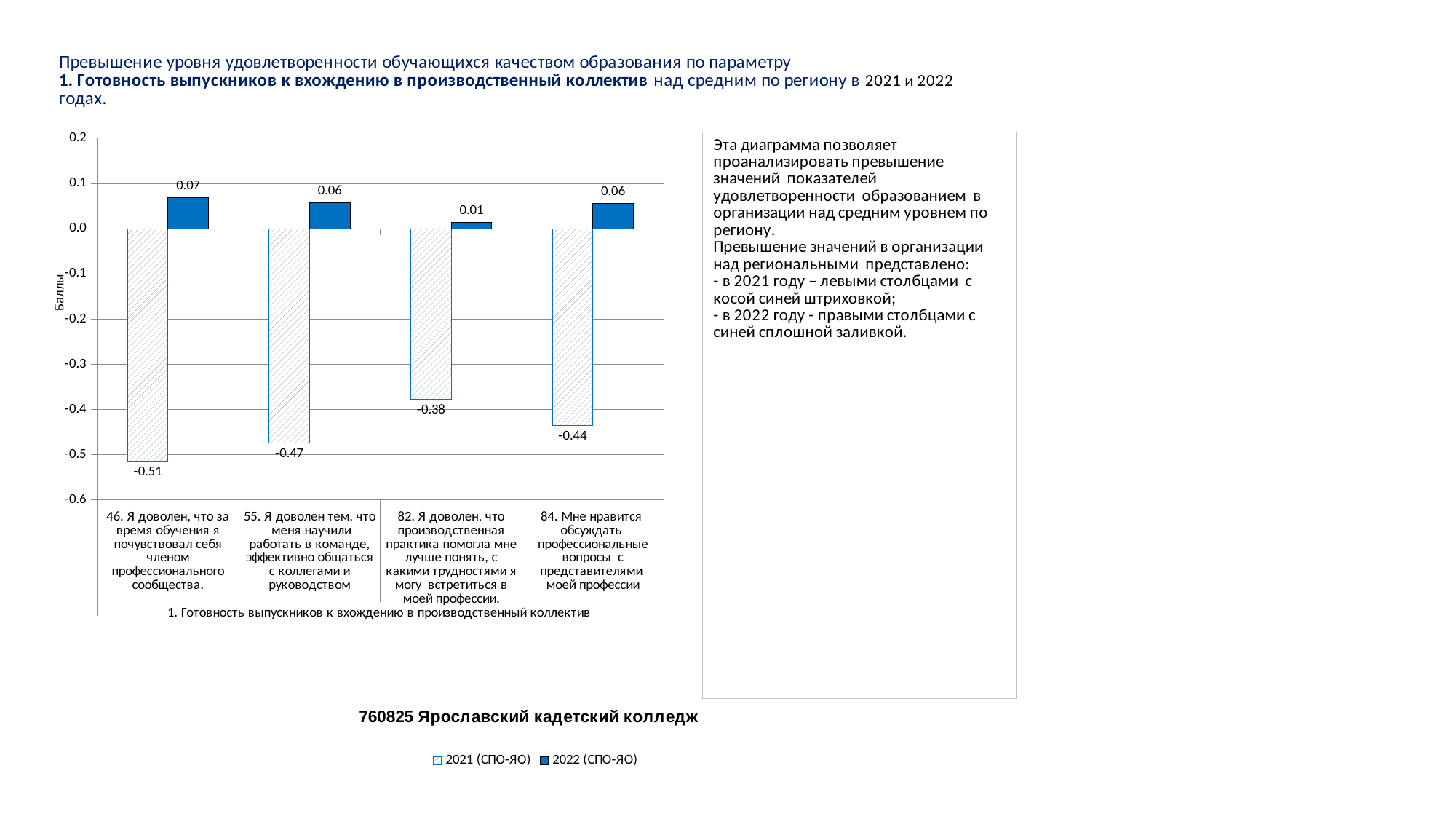
Which category has the highest value in the 2022 (СПО-ЯО) series? 46. Я доволен, что за время обучения я почувствовал себя членом профессионального сообщества. What is the value of the 2021 (СПО-ЯО) series for category 46 ("Я доволен, что за время обучения я почувствовал себя членом профессионального сообщества")? -0.51 What kind of chart is shown on the slide? Bar chart How many categories are shown on the x axis of the chart? 4 Is the 2021 (СПО-ЯО) value for category 46 greater or less than -0.5? less How many series does the legend list? 2 What is the value of the 2021 (СПО-ЯО) series for category 84 ("Мне нравится обсуждать профессиональные вопросы с представителями моей профессии")? -0.44 What is the difference between the 2022 and 2021 values for category 55 ("Я доволен тем, что меня научили работать в команде...")? 0.53 Which is larger: the 2021 value for category 82 or the 2021 value for category 84? Category 82 (-0.38) What is the value of the 2022 (СПО-ЯО) series for category 82 ("Я доволен, что производственная практика помогла мне лучше понять...")? 0.01 What is the label of the vertical axis of the chart? Баллы Which category has the lowest value in the 2021 (СПО-ЯО) series? 46. Я доволен, что за время обучения я почувствовал себя членом профессионального сообщества.